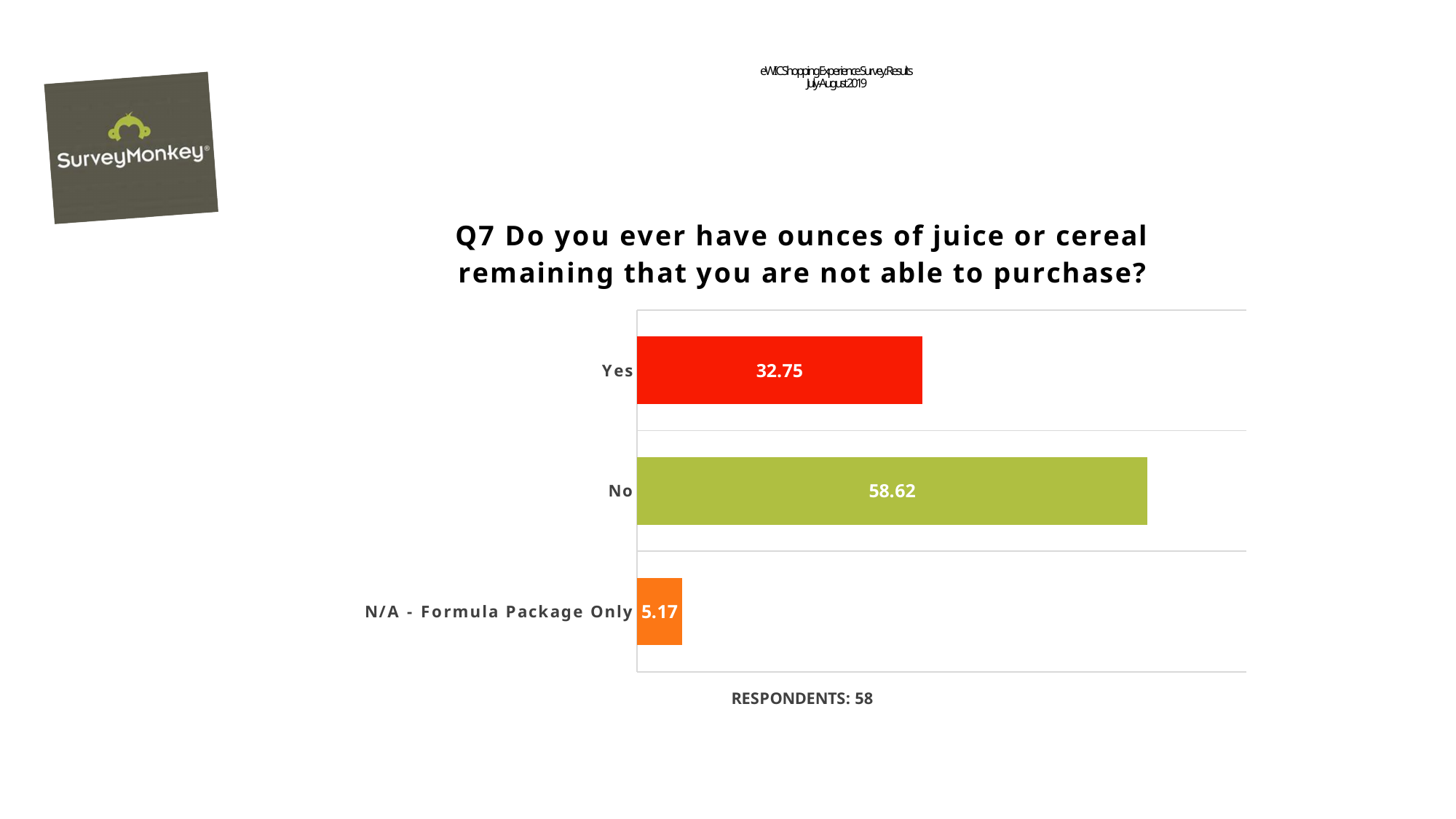
What is the value for "No"? 58.62 Which is larger, the value for "Yes" or the value for "No"? No What kind of chart is shown on the slide? Bar chart Which category has the highest value? No How many respondents does the chart report? 58 What is the difference between the values for "Yes" and "N/A - Formula Package Only"? 27.58 What is the value for "N/A - Formula Package Only"? 5.17 Which category has the lowest value? N/A - Formula Package Only How many categories are shown in the chart? 3 What is the value for "Yes"? 32.75 What colour is the bar for "No"? Green What is the difference between the values for "No" and "Yes"? 25.87